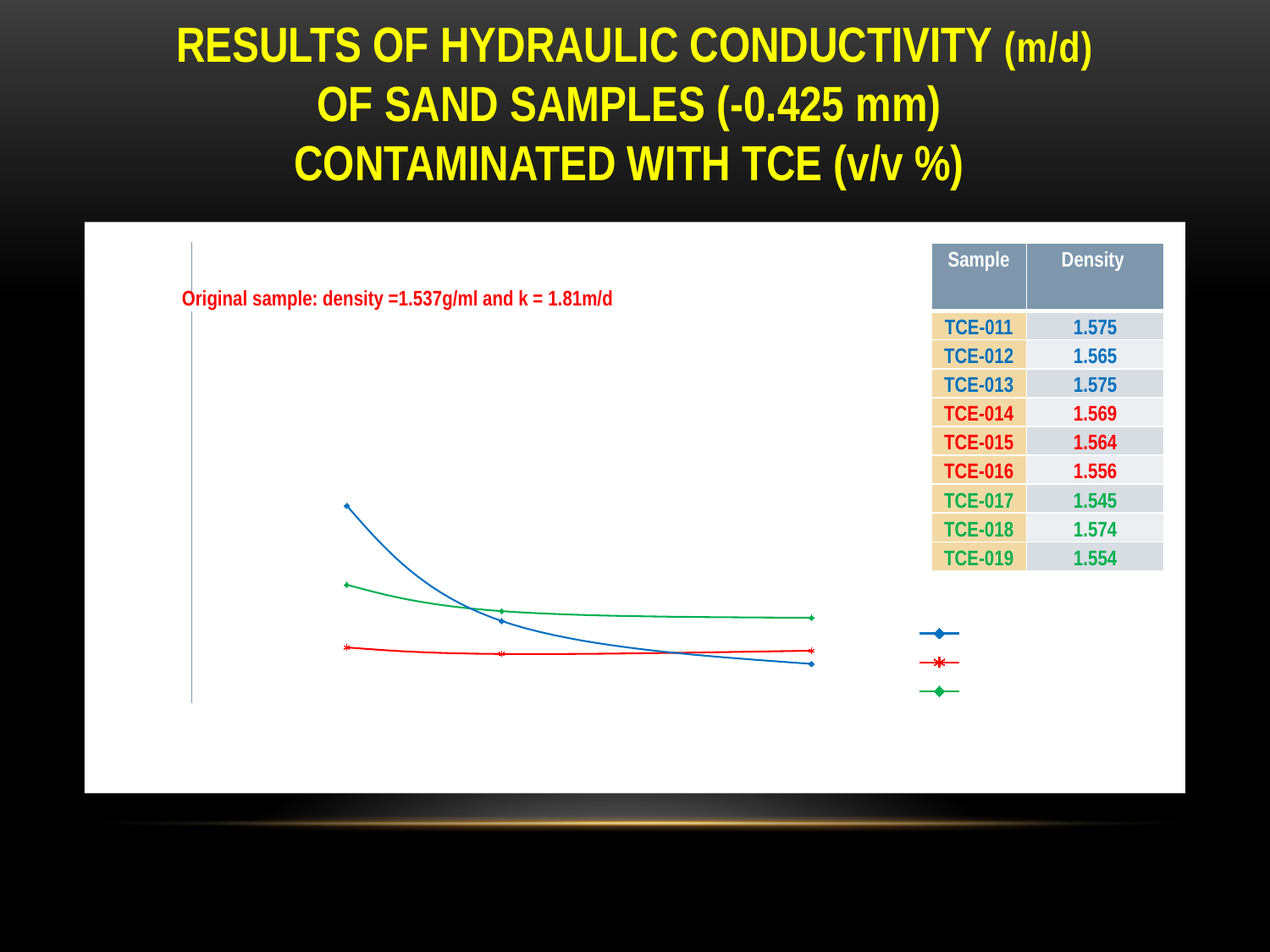
At the leftmost data point, is the green line's value larger or smaller than the red line's value? larger According to the note on the chart, what is the hydraulic conductivity k of the original sample? 1.81m/d Does the blue line rise or fall from left to right along the x axis? fall Which line has the lowest value at the leftmost data point? the red line How many data points does the blue line have? 3 At the rightmost data point, is the blue line's value larger or smaller than the green line's value? smaller What kind of chart is shown on the slide? line chart Does the green line rise or fall from left to right along the x axis? fall Which line has the highest value at the rightmost data point? the green line How many series does the chart's legend list? 3 Which line has the highest value at the leftmost data point? the blue line According to the note on the chart, what is the density of the original sample? 1.537g/ml